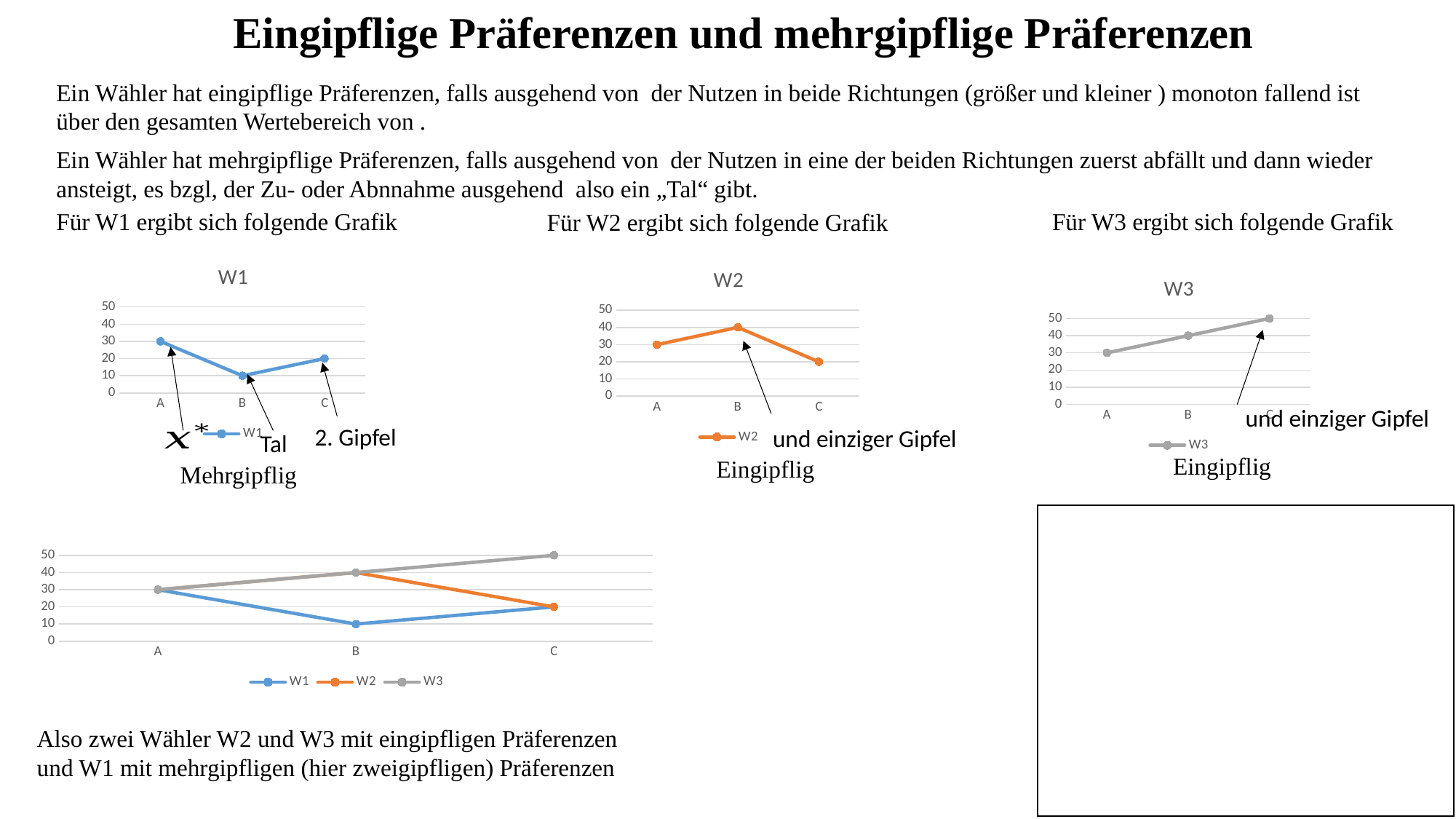
In the chart titled W2, which is larger, the value at A or the value at C? A In the chart titled W1, which category has the lowest value? B What kind of chart is the chart titled W3? line chart In the chart titled W3, do the values rise or fall from A to C? rise In the combined chart at the bottom left, what colour is the W2 line? orange How many series does the legend of the combined chart at the bottom left list? 3 How many categories are shown on the x axis of the combined chart at the bottom left? 3 In the chart titled W1, what is the value at category B? 10 In the chart titled W2, what is the value at category B? 40 In the chart titled W2, which category has the highest value? B In the chart titled W3, what is the value at category C? 50 In the chart titled W1, what is the difference between the values at A and B? 20